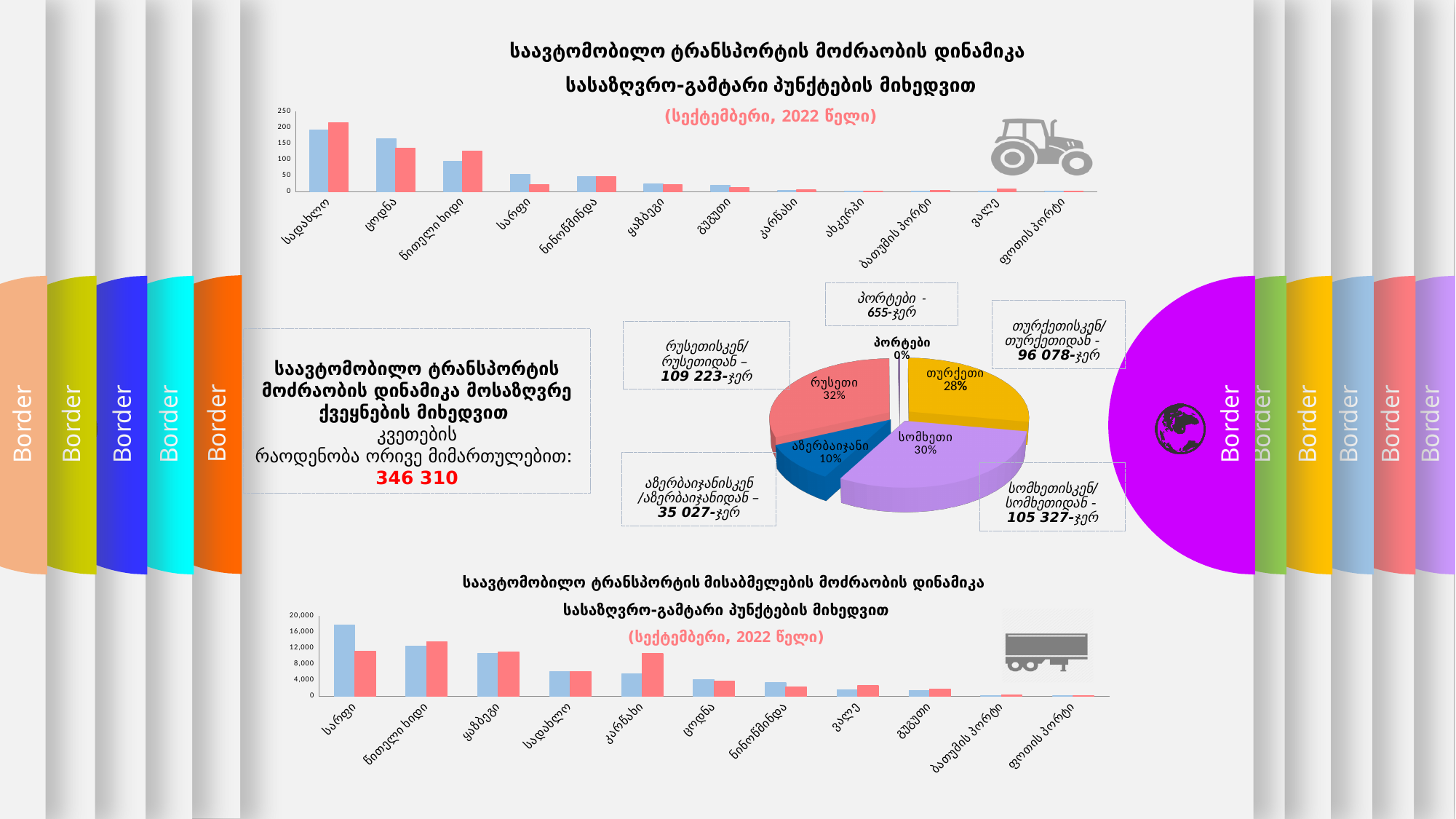
In the pie chart in the middle of the slide, what share does თურქეთი have? 28% In the top bar chart, is the value of the blue bar for სადახლო greater or less than 150? greater How many categories are shown on the x axis of the top bar chart? 12 How many categories are shown on the x axis of the bottom bar chart? 11 In the pie chart in the middle of the slide, which slice is the largest? რუსეთი In the pie chart in the middle of the slide, which slice is the smallest? პორტები How many slices does the pie chart in the middle of the slide have? 5 Using the callout values next to the pie chart, what is the difference between რუსეთი (109 223) and სომხეთი (105 327)? 3 896 In the bottom bar chart, is the value of the blue bar for სარფი greater or less than 16,000? greater In the pie chart in the middle of the slide, what share does რუსეთი have? 32% According to the callout next to the pie chart, what is the value for აზერბაიჯანი? 35 027-ჯერ What kind of chart is the top chart on the slide? bar chart